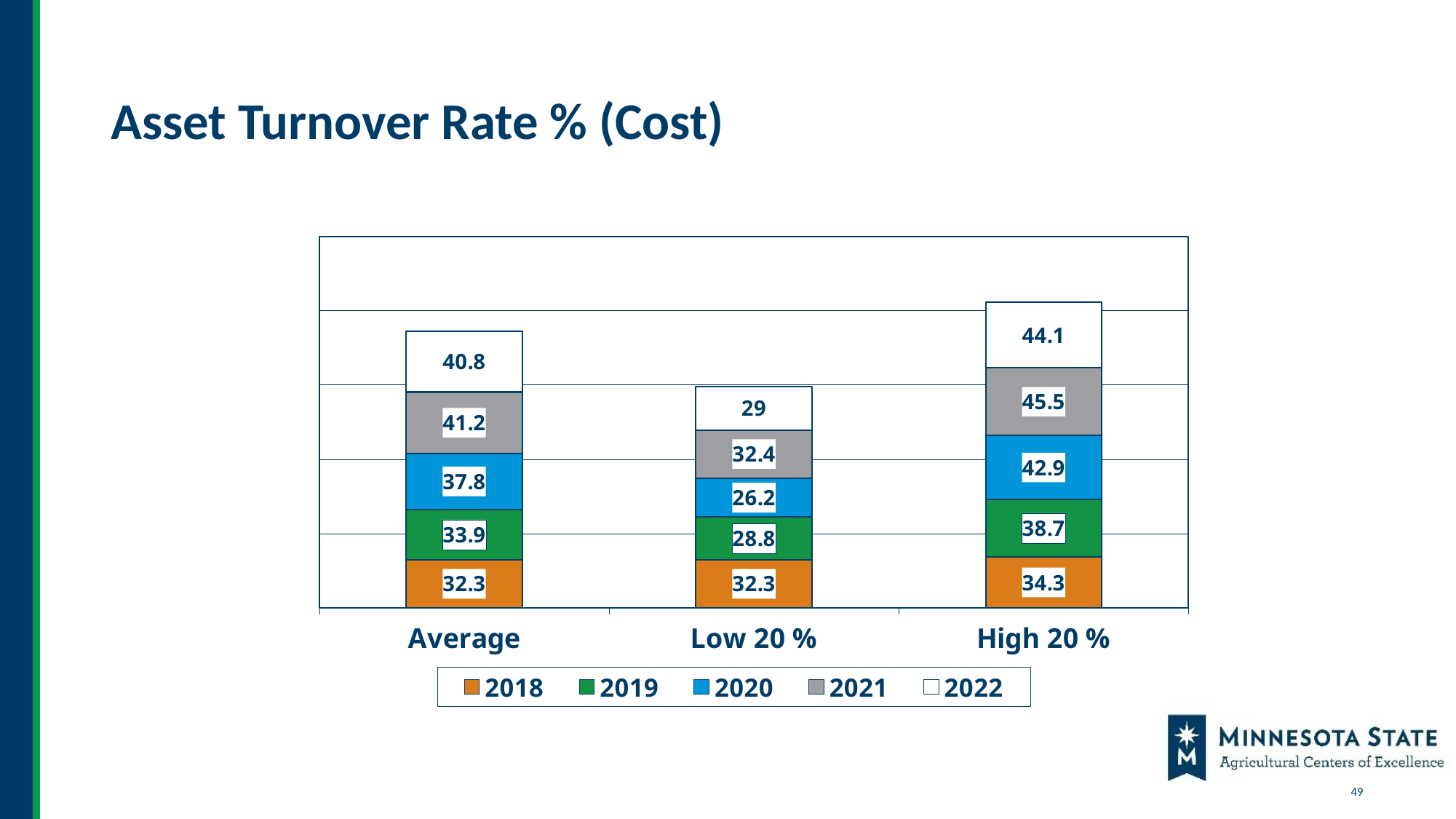
How many series does the legend list? 5 What kind of chart is shown? Stacked bar chart What is the 2021 value for Average? 41.2 What is the 2022 value for High 20 %? 44.1 Which series is shown in orange in the legend? 2018 Which is larger, the 2020 value for Average or the 2020 value for High 20 %? High 20 % What is the total of the stacked bar for Low 20 %? 148.7 Which category has the highest 2019 value? High 20 % Which category has the lowest 2022 value? Low 20 % What is the difference between the 2021 values for High 20 % and Low 20 %? 13.1 What is the 2020 value for Low 20 %? 26.2 How many categories are shown on the x axis? 3